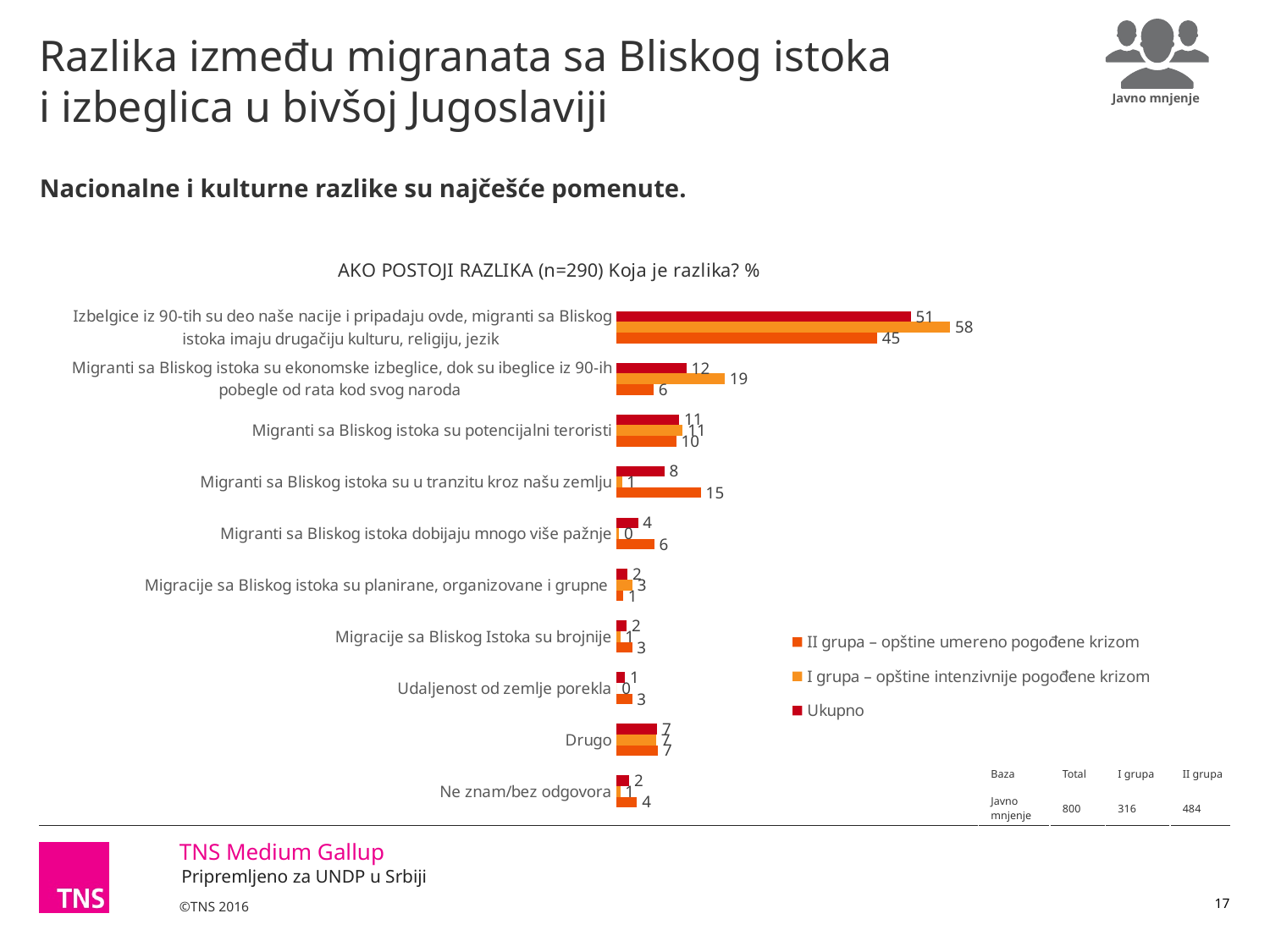
What is the Ukupno value for "Izbeglice iz 90-tih su deo naše nacije i pripadaju ovde, migranti sa Bliskog istoka imaju drugačiju kulturu, religiju, jezik"? 51 What is the I grupa value for "Migranti sa Bliskog istoka su ekonomske izbeglice, dok su ibeglice iz 90-ih pobegle od rata kod svog naroda"? 19 How many categories are shown in the chart? 10 What is the difference between the Ukupno and II grupa values for "Migranti sa Bliskog istoka su ekonomske izbeglice, dok su ibeglice iz 90-ih pobegle od rata kod svog naroda"? 6 What type of chart is shown on the slide? Bar chart What is the II grupa value for "Migranti sa Bliskog istoka su u tranzitu kroz našu zemlju"? 15 What is the title of the chart? AKO POSTOJI RAZLIKA (n=290) Koja je razlika? % What is the Ukupno value for "Drugo"? 7 How many series does the legend list? 3 What is the difference between the I grupa and II grupa values for "Izbeglice iz 90-tih su deo naše nacije i pripadaju ovde, migranti sa Bliskog istoka imaju drugačiju kulturu, religiju, jezik"? 13 For "Migranti sa Bliskog istoka su u tranzitu kroz našu zemlju", which is larger: the I grupa value or the II grupa value? II grupa Which category has the highest Ukupno value? Izbeglice iz 90-tih su deo naše nacije i pripadaju ovde, migranti sa Bliskog istoka imaju drugačiju kulturu, religiju, jezik